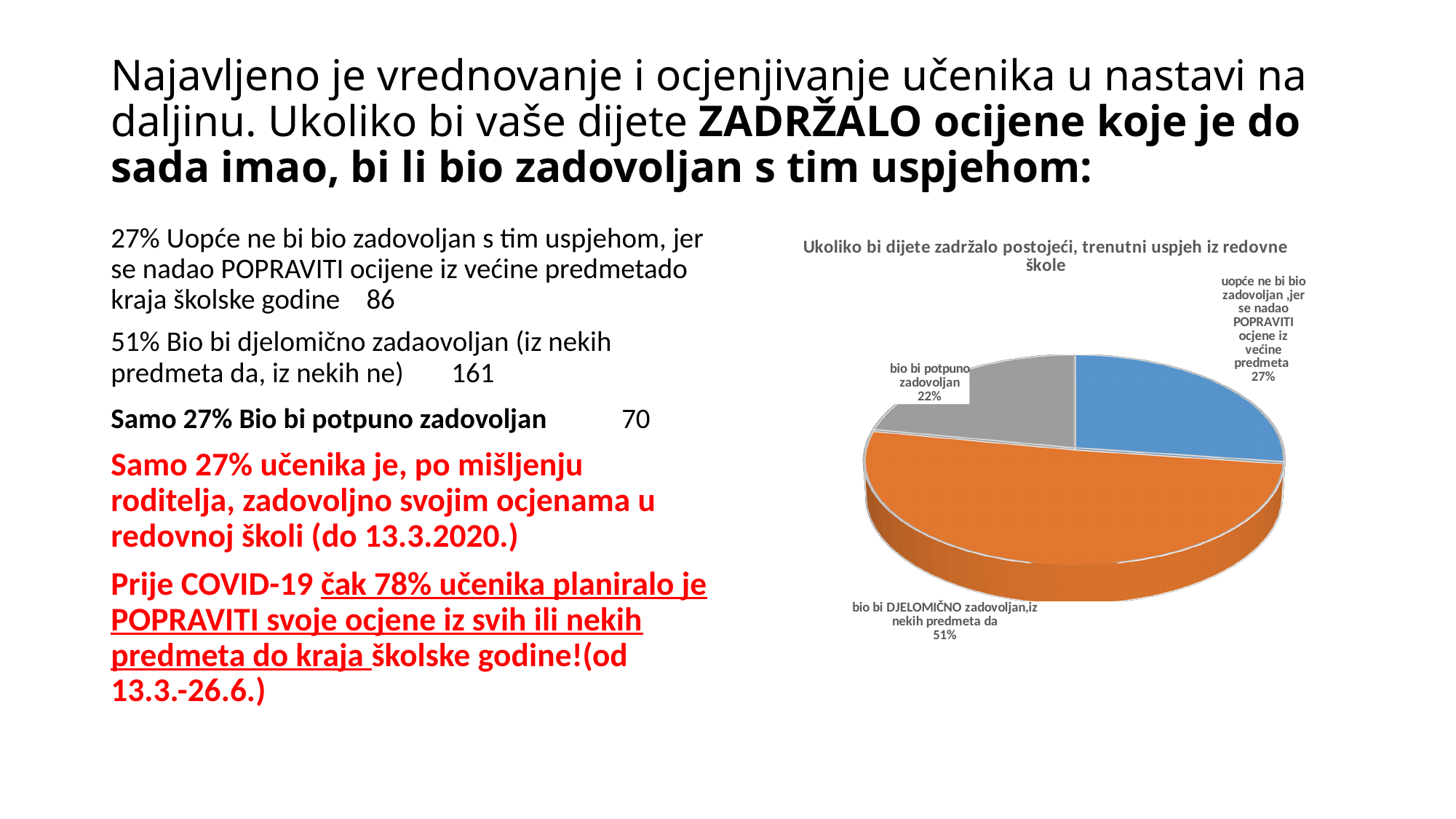
What share of the pie is labelled "bio bi DJELOMIČNO zadovoljan, iz nekih predmeta da"? 51% What is the title of the pie chart? Ukoliko bi dijete zadržalo postojeći, trenutni uspjeh iz redovne škole Which is larger in the pie chart: the "uopće ne bi bio zadovoljan" slice or the "bio bi potpuno zadovoljan" slice? uopće ne bi bio zadovoljan What is the difference in percentage points between the "bio bi DJELOMIČNO zadovoljan" slice and the "bio bi potpuno zadovoljan" slice? 29 What share of the pie is labelled "bio bi potpuno zadovoljan"? 22% What kind of chart is shown on the slide? pie chart What share of the pie is labelled "uopće ne bi bio zadovoljan, jer se nadao POPRAVITI ocjene iz većine predmeta"? 27% What colour is the "bio bi DJELOMIČNO zadovoljan" slice in the pie chart? orange Which slice of the pie chart is the smallest? bio bi potpuno zadovoljan What is the difference in percentage points between the "uopće ne bi bio zadovoljan" slice and the "bio bi potpuno zadovoljan" slice? 5 Which slice of the pie chart is the largest? bio bi DJELOMIČNO zadovoljan, iz nekih predmeta da How many slices does the pie chart have? 3